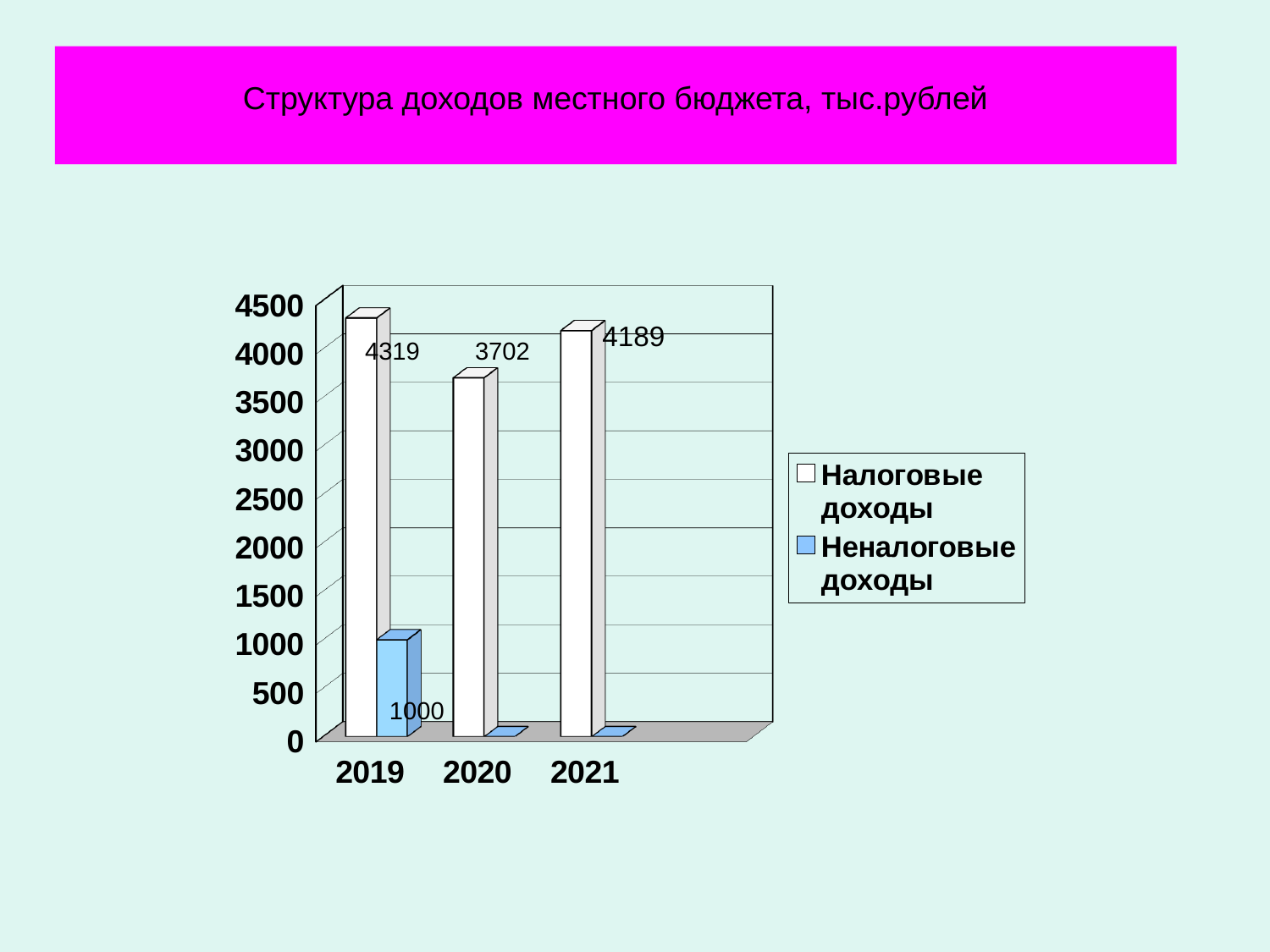
In which year is Налоговые доходы the highest? 2019 Is the value of Неналоговые доходы for 2020 greater or less than 500? less What is the difference between Налоговые доходы in 2021 and 2020? 487 What is the value of Налоговые доходы for 2020? 3702 What is the value of Налоговые доходы for 2019? 4319 In which year is Налоговые доходы the lowest? 2020 What is the difference between Налоговые доходы in 2019 and 2020? 617 What is the value of Налоговые доходы for 2021? 4189 How many series does the legend list? 2 Which is larger: Налоговые доходы in 2019 or in 2021? 2019 What type of chart is shown on the slide? Bar chart What is the value of Неналоговые доходы for 2019? 1000